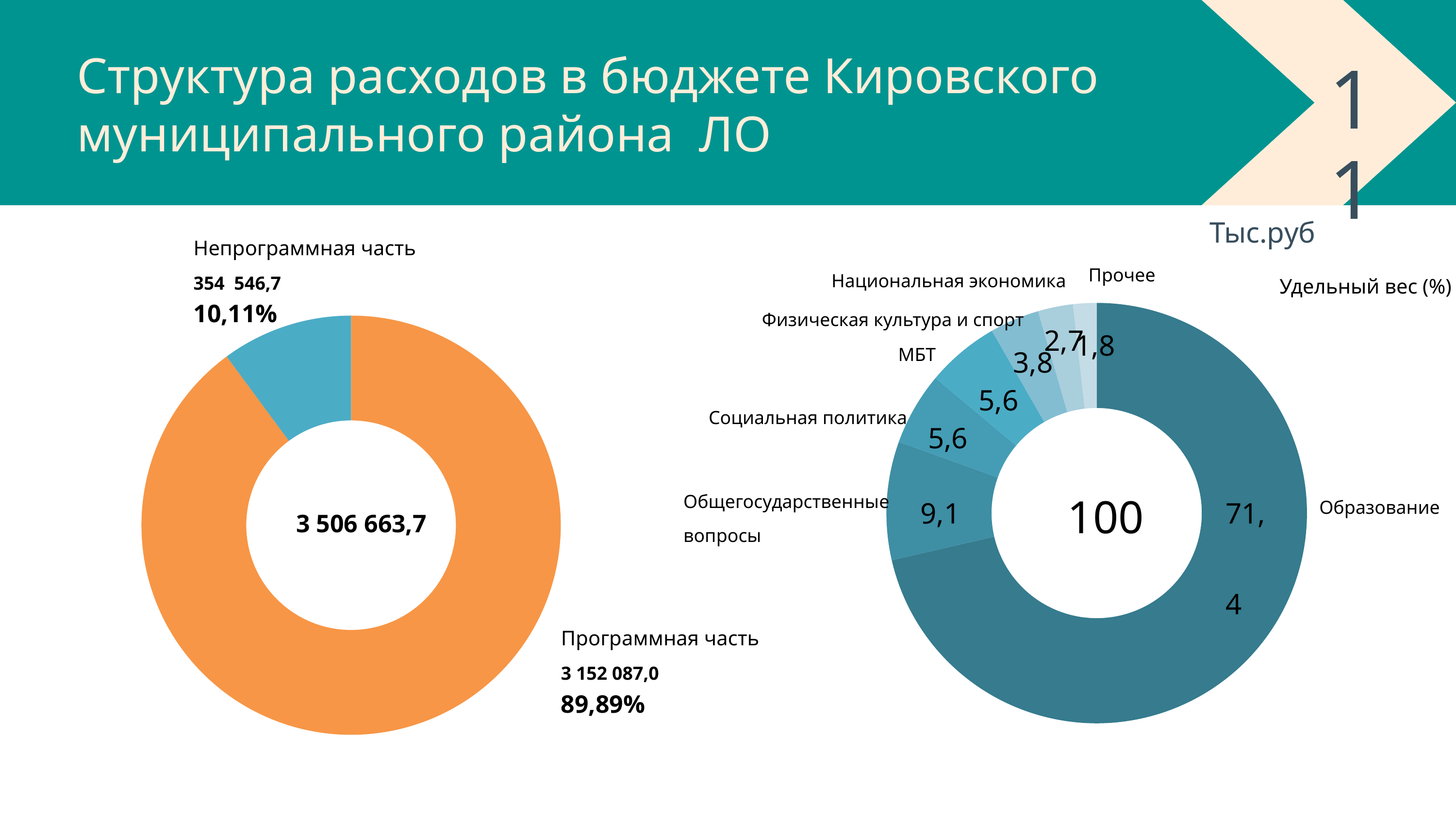
On the right donut chart (Удельный вес (%)), how many categories are shown? 7 On the left donut chart, which part is larger, Программная часть or Непрограммная часть? Программная часть On the left donut chart, what percentage share is shown for Программная часть? 89,89% On the left donut chart, what total value is printed in the centre? 3 506 663,7 On the left donut chart, how many categories are shown? 2 On the right donut chart (Удельный вес (%)), what is the value for Общегосударственные вопросы? 9,1 On the right donut chart (Удельный вес (%)), which category has the largest share? Образование On the right donut chart (Удельный вес (%)), which category has the smallest share? Прочее On the left donut chart, what is the value for Непрограммная часть? 354 546,7 What kind of chart is the chart on the right (Удельный вес (%))? Donut (pie) chart On the left donut chart, what percentage share is shown for Непрограммная часть? 10,11% On the right donut chart (Удельный вес (%)), what is the value for Физическая культура и спорт? 3,8